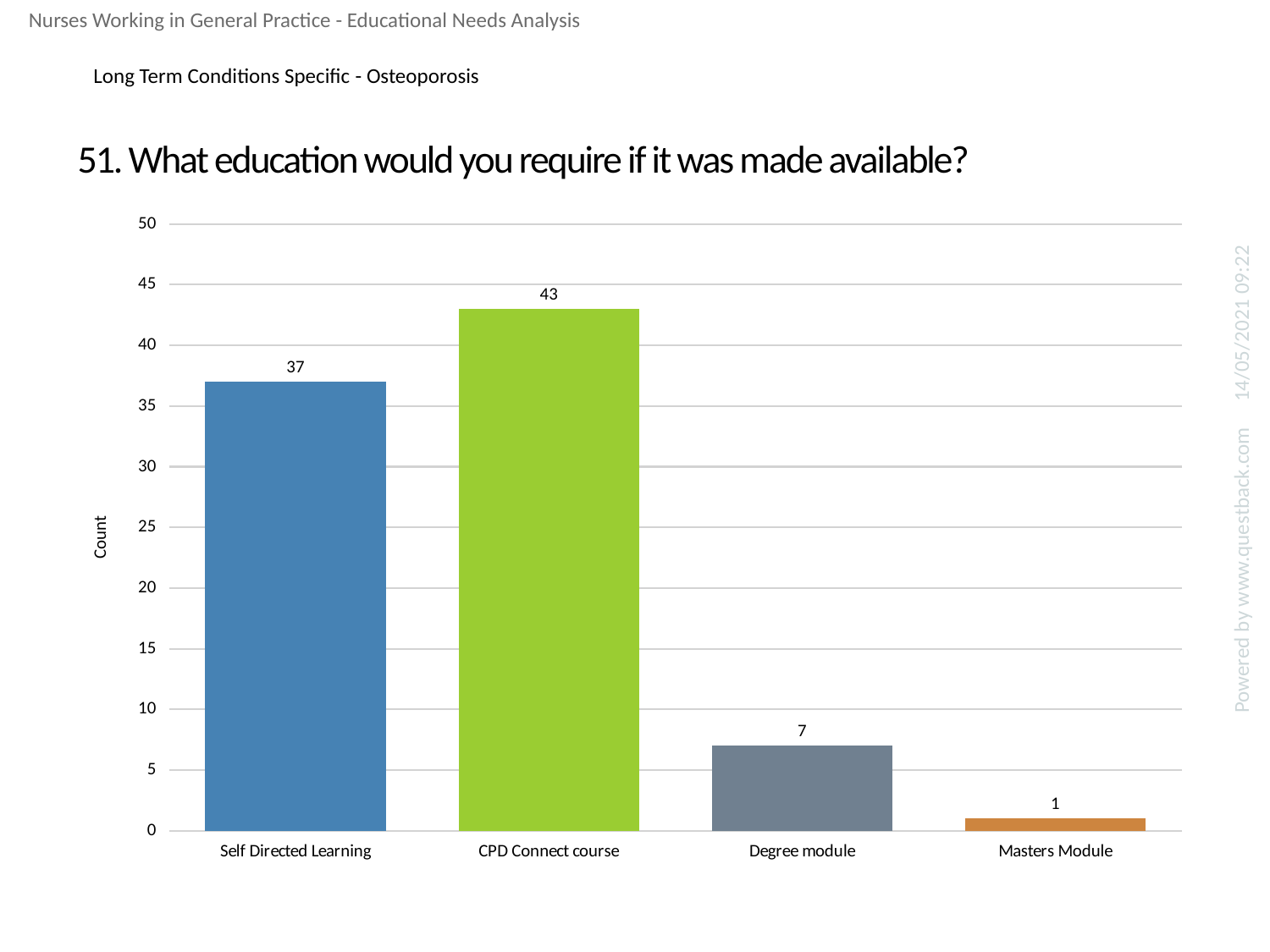
Which category has the lowest count? Masters Module How many categories are shown on the x axis? 4 What is the label of the y axis? Count Is the value for Self Directed Learning greater or less than 40? less What kind of chart is shown on the slide? bar chart Which has a larger count, Degree module or Masters Module? Degree module What is the difference between the counts for CPD Connect course and Self Directed Learning? 6 What is the count for Masters Module? 1 What is the count for Self Directed Learning? 37 What is the count for CPD Connect course? 43 Which category has the highest count? CPD Connect course What is the count for Degree module? 7